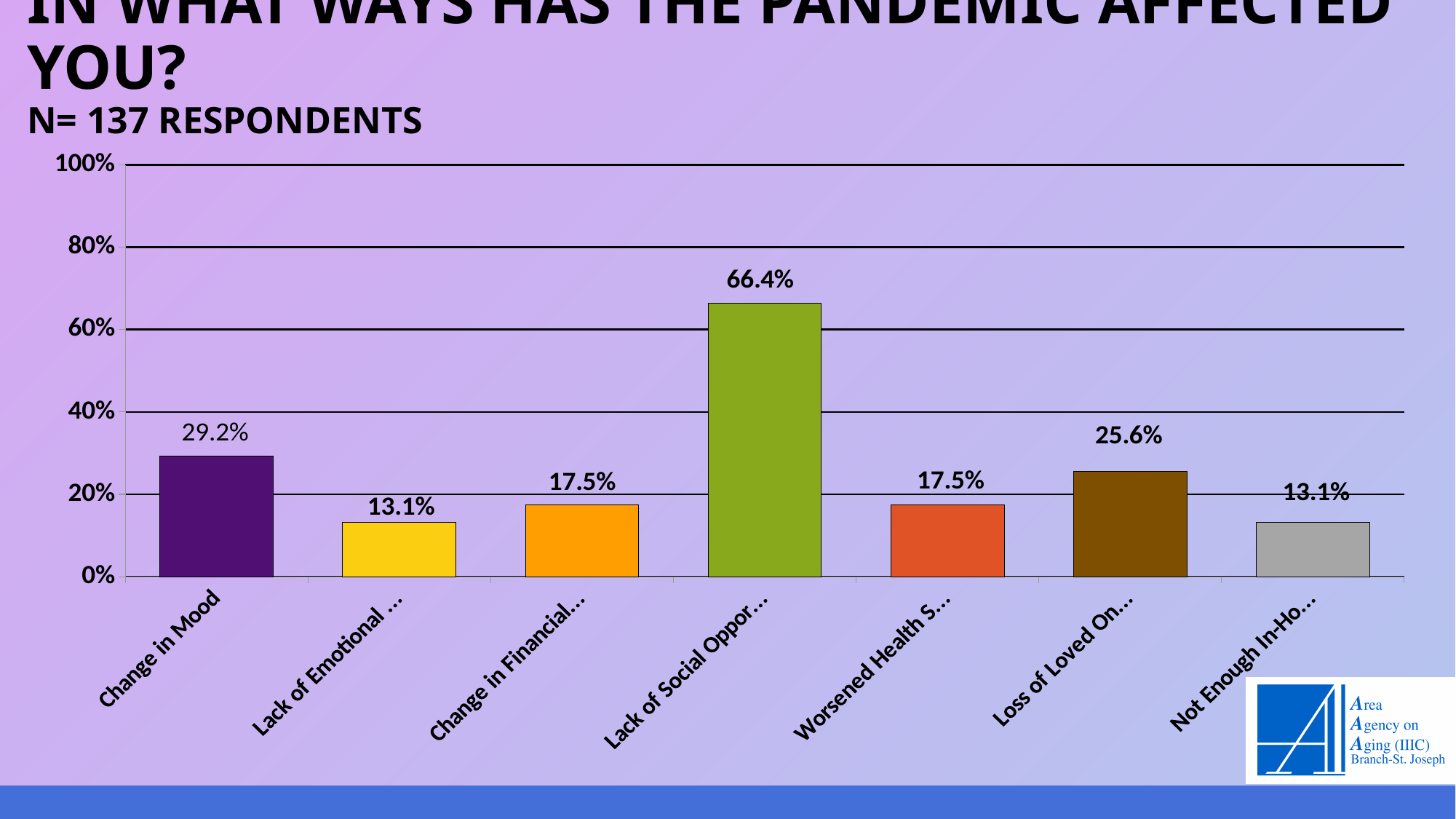
What is the difference between the value for "Change in Financial…" and the value for "Lack of Emotional …"? 4.4% What is the value for Change in Mood? 29.2% Which category has the highest value? Lack of Social Oppor… How many respondents does the slide say took part in the survey? 137 What kind of chart is shown on the slide? bar chart What is the value for the bar labelled "Worsened Health S…"? 17.5% Is the value for "Lack of Social Oppor…" greater or less than 60%? greater What is the value for the bar labelled "Lack of Social Oppor…"? 66.4% What is the value for the bar labelled "Loss of Loved On…"? 25.6% How many categories (bars) does the chart show? 7 Which is larger, the value for Change in Mood or the value for "Loss of Loved On…"? Change in Mood What is the difference between the value for "Lack of Social Oppor…" and the value for Change in Mood? 37.2%